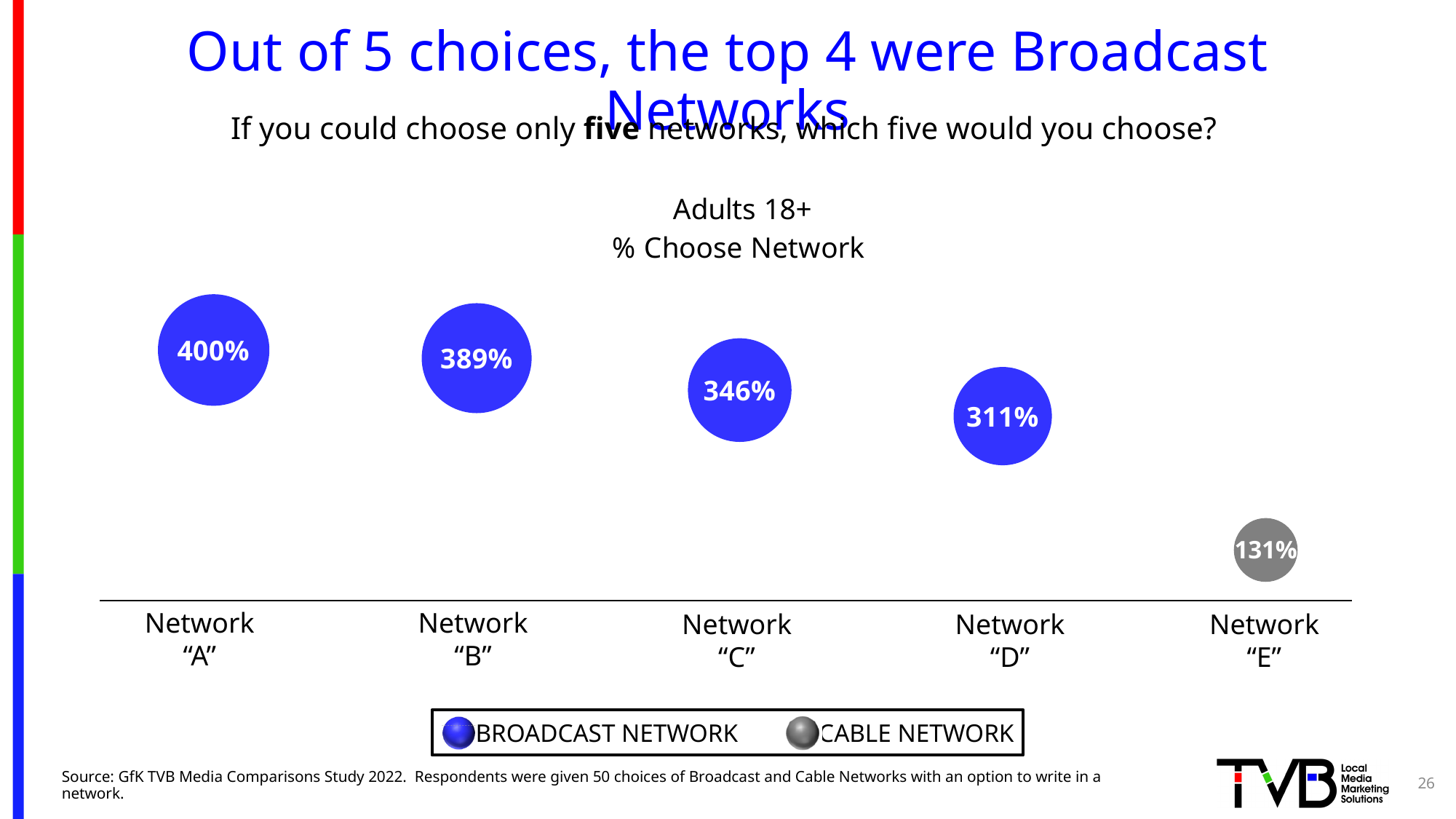
How many entries does the legend list? 2 What is the difference between the values for Network "D" and Network "E"? 180% Which network has the highest value? Network "A" Which network is shown as a Cable Network in the chart? Network "E" Which is larger, the value for Network "B" or Network "D"? Network "B" What is the value for Network "E"? 131% What is the difference between the values for Network "A" and Network "B"? 11% How many networks are shown in the chart? 5 Do the values rise or fall from Network "A" to Network "E"? fall Which network has the lowest value? Network "E" What is the value for Network "C"? 346% What is the value for Network "A"? 400%